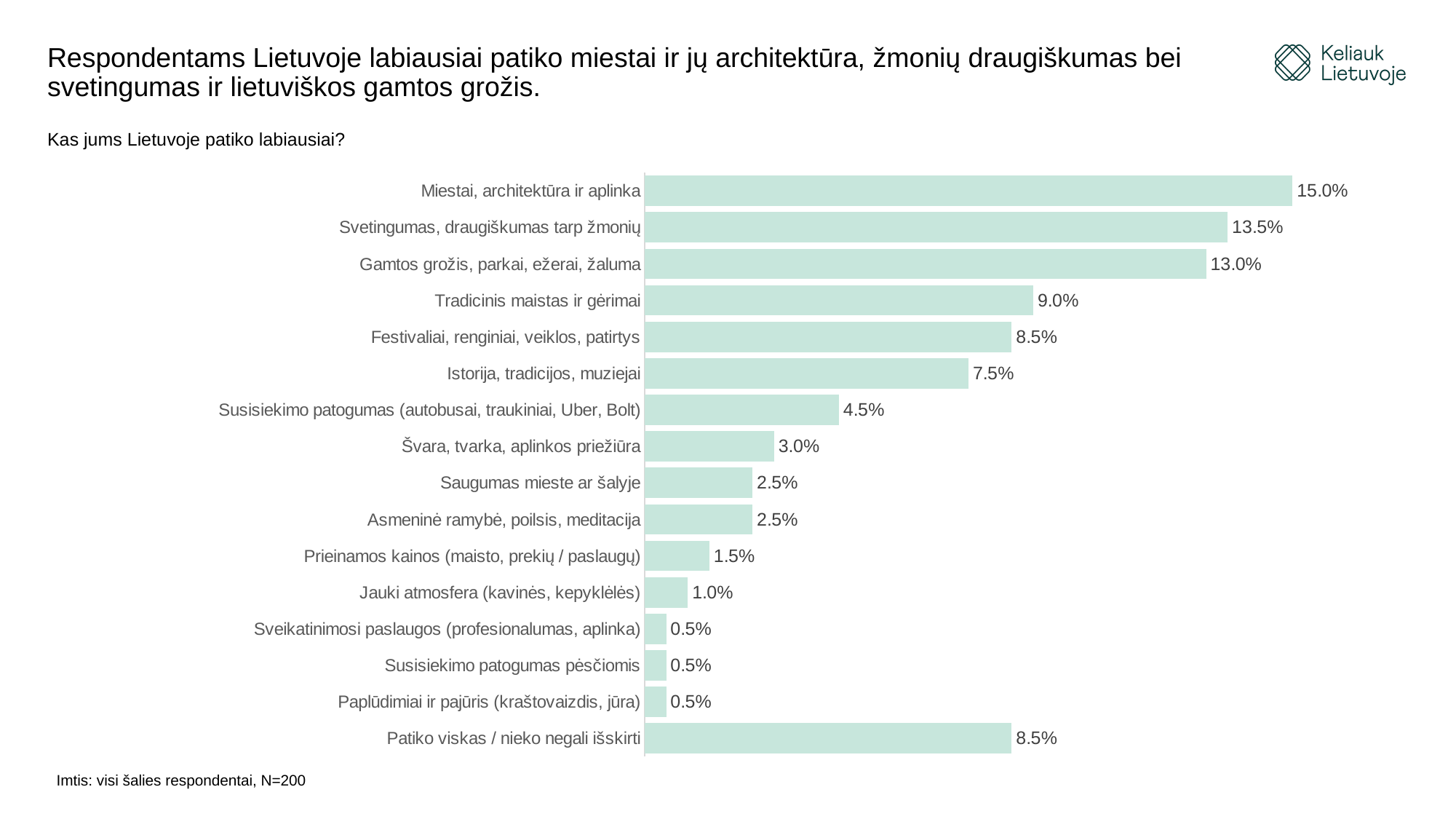
Which is larger: "Festivaliai, renginiai, veiklos, patirtys" or "Istorija, tradicijos, muziejai"? Festivaliai, renginiai, veiklos, patirtys What is the value for "Tradicinis maistas ir gėrimai"? 9.0% What is the difference between "Miestai, architektūra ir aplinka" and "Istorija, tradicijos, muziejai"? 7.5% How many categories are shown in the chart? 16 What is the value for "Susisiekimo patogumas (autobusai, traukiniai, Uber, Bolt)"? 4.5% What is the difference between "Svetingumas, draugiškumas tarp žmonių" and "Gamtos grožis, parkai, ežerai, žaluma"? 0.5% What is the value for "Patiko viskas / nieko negali išskirti"? 8.5% What is the value for "Jauki atmosfera (kavinės, kepyklėlės)"? 1.0% Which category has the highest value? Miestai, architektūra ir aplinka What kind of chart is shown on the slide? Bar chart What is the sample size stated below the chart? N=200 What is the value for "Miestai, architektūra ir aplinka"? 15.0%